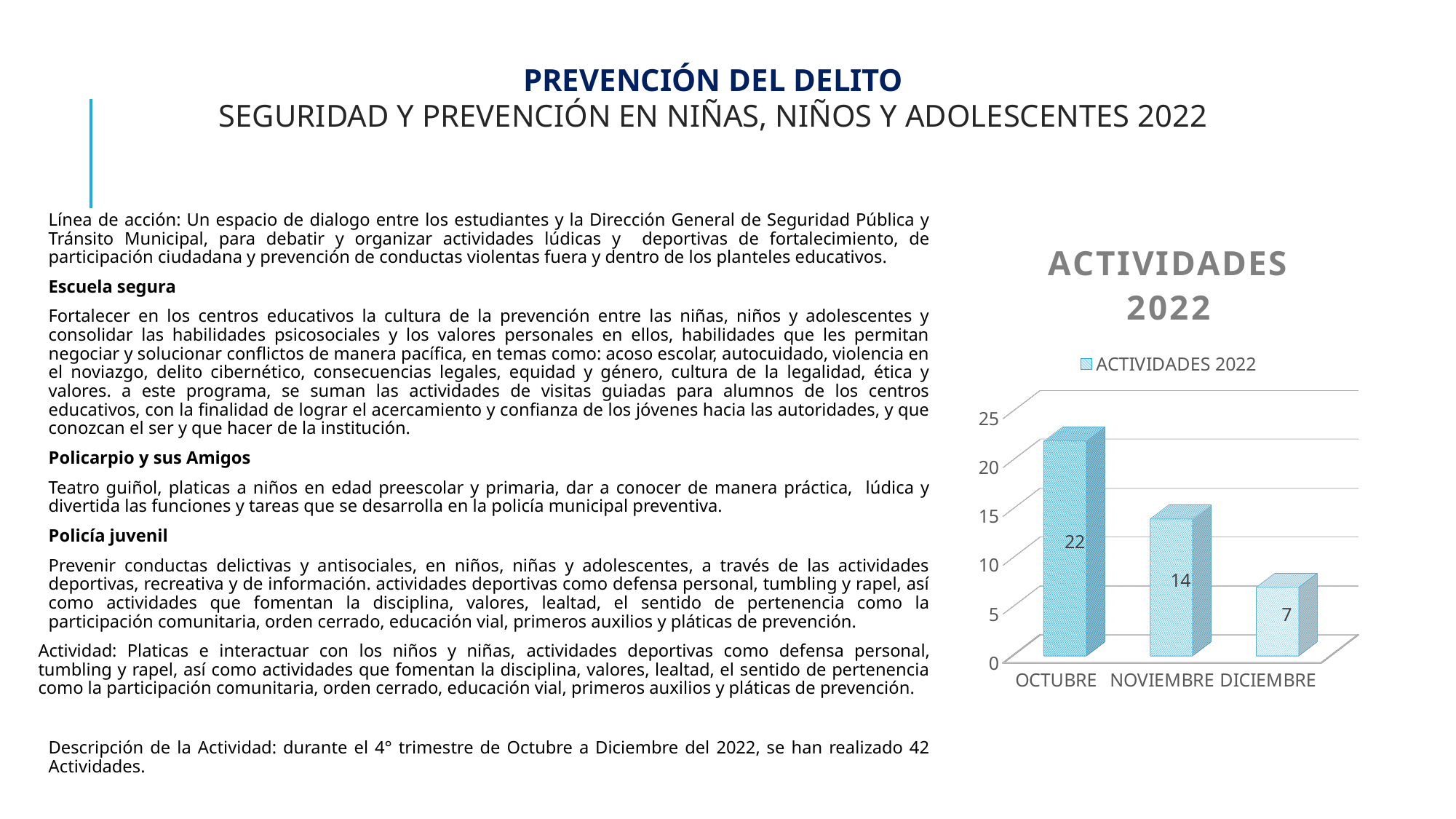
What is the value for OCTUBRE in the ACTIVIDADES 2022 chart? 22 How many series does the legend of the ACTIVIDADES 2022 chart list? 1 Which month has the highest value in the ACTIVIDADES 2022 chart? OCTUBRE Which is larger in the ACTIVIDADES 2022 chart, the value for NOVIEMBRE or DICIEMBRE? NOVIEMBRE Which month has the lowest value in the ACTIVIDADES 2022 chart? DICIEMBRE What is the value for DICIEMBRE in the ACTIVIDADES 2022 chart? 7 What is the difference between the values for OCTUBRE and NOVIEMBRE in the ACTIVIDADES 2022 chart? 8 How many months are shown on the x axis of the ACTIVIDADES 2022 chart? 3 What kind of chart is the ACTIVIDADES 2022 chart? Bar chart What is the difference between the values for NOVIEMBRE and DICIEMBRE in the ACTIVIDADES 2022 chart? 7 What is the value for NOVIEMBRE in the ACTIVIDADES 2022 chart? 14 Do the values in the ACTIVIDADES 2022 chart rise or fall from OCTUBRE to DICIEMBRE? Fall